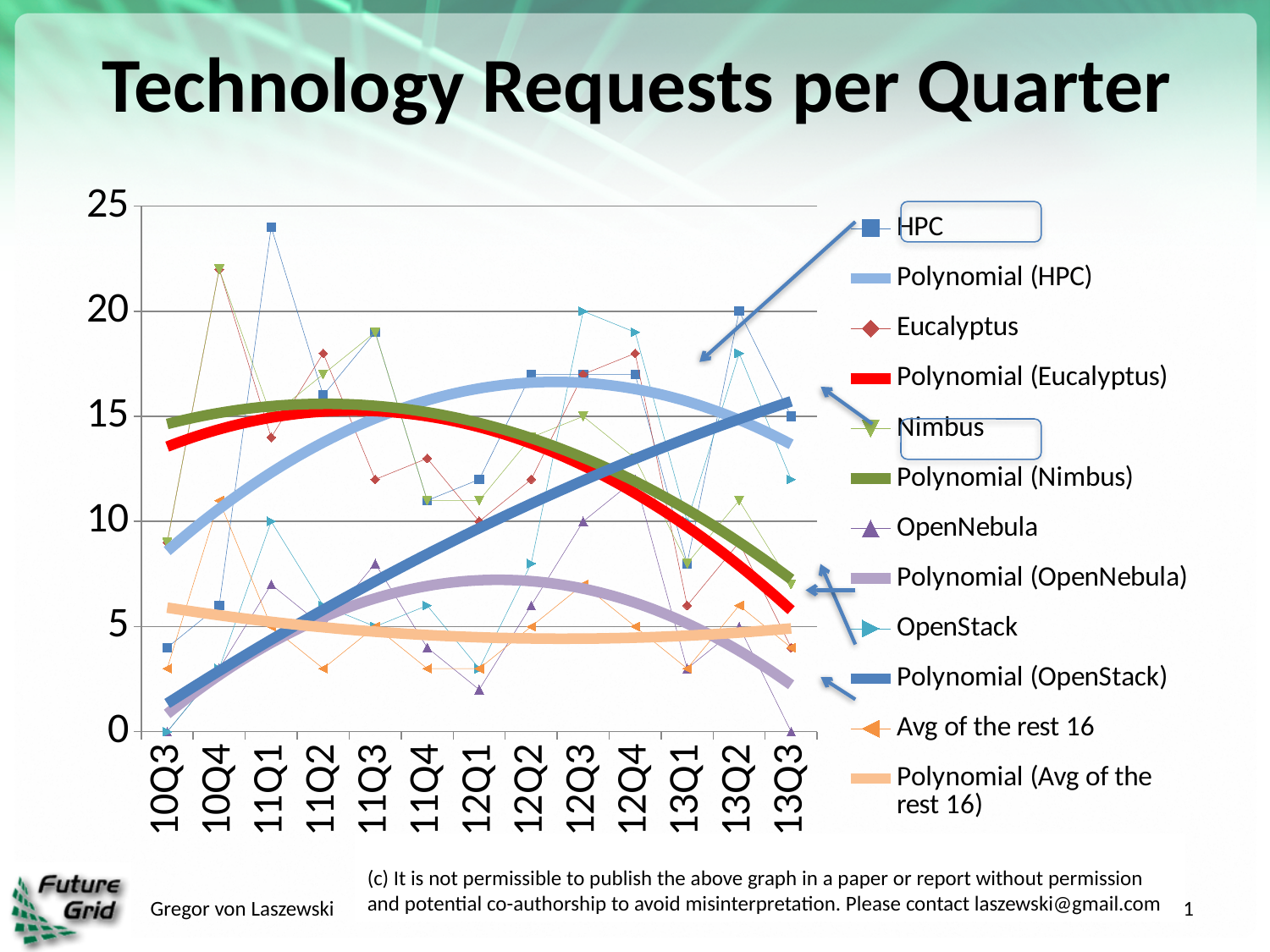
What is the OpenStack value for 10Q3? 0 What is the OpenNebula value for 13Q3? 0 Is the HPC value for 10Q3 greater or less than 5? less Is the HPC value for 11Q1 greater or less than 20? greater Is the Eucalyptus value for 10Q4 greater or less than 20? greater How many quarters are shown along the x axis? 13 What kind of chart is shown on the slide? line chart Which is larger at 11Q1, the HPC value or the Eucalyptus value? HPC Does the Polynomial (OpenStack) trend line rise or fall from 10Q3 to 13Q3? rise What is the title of the chart? Technology Requests per Quarter How many entries does the legend list? 12 In which quarter does the HPC series reach its highest value? 11Q1